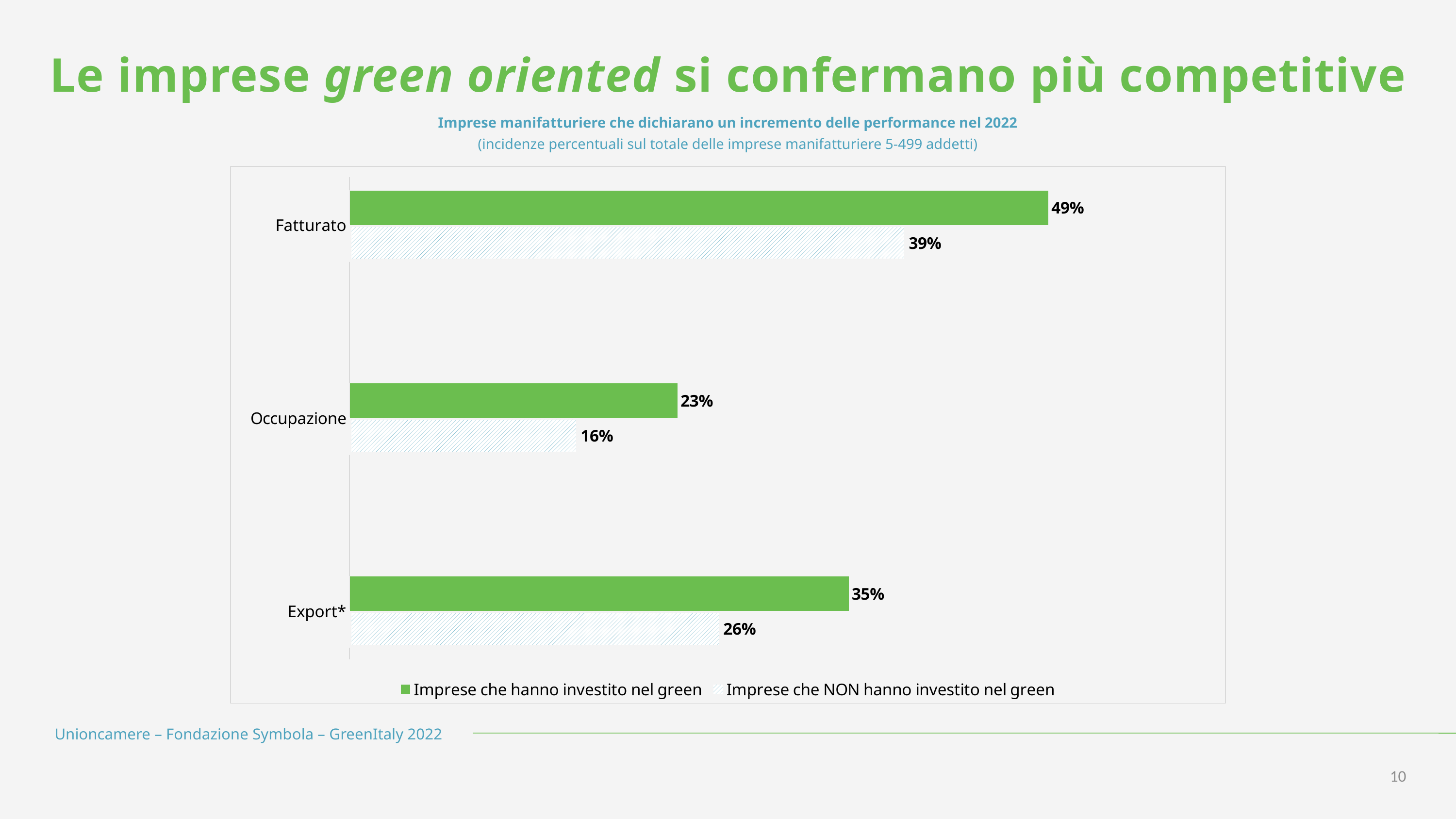
What is the difference between the two series for Fatturato? 10% What is the value for Occupazione for Imprese che NON hanno investito nel green? 16% Which category has the highest value for Imprese che hanno investito nel green? Fatturato How many series does the legend list? 2 What is the value for Fatturato for Imprese che hanno investito nel green? 49% Which category has the lowest value for Imprese che NON hanno investito nel green? Occupazione For Occupazione, which series has the larger value? Imprese che hanno investito nel green What is the value for Export* for Imprese che hanno investito nel green? 35% What is the difference between the two series for Export*? 9% How many categories are shown on the chart? 3 What is the value for Fatturato for Imprese che NON hanno investito nel green? 39% What kind of chart is shown on the slide? Bar chart